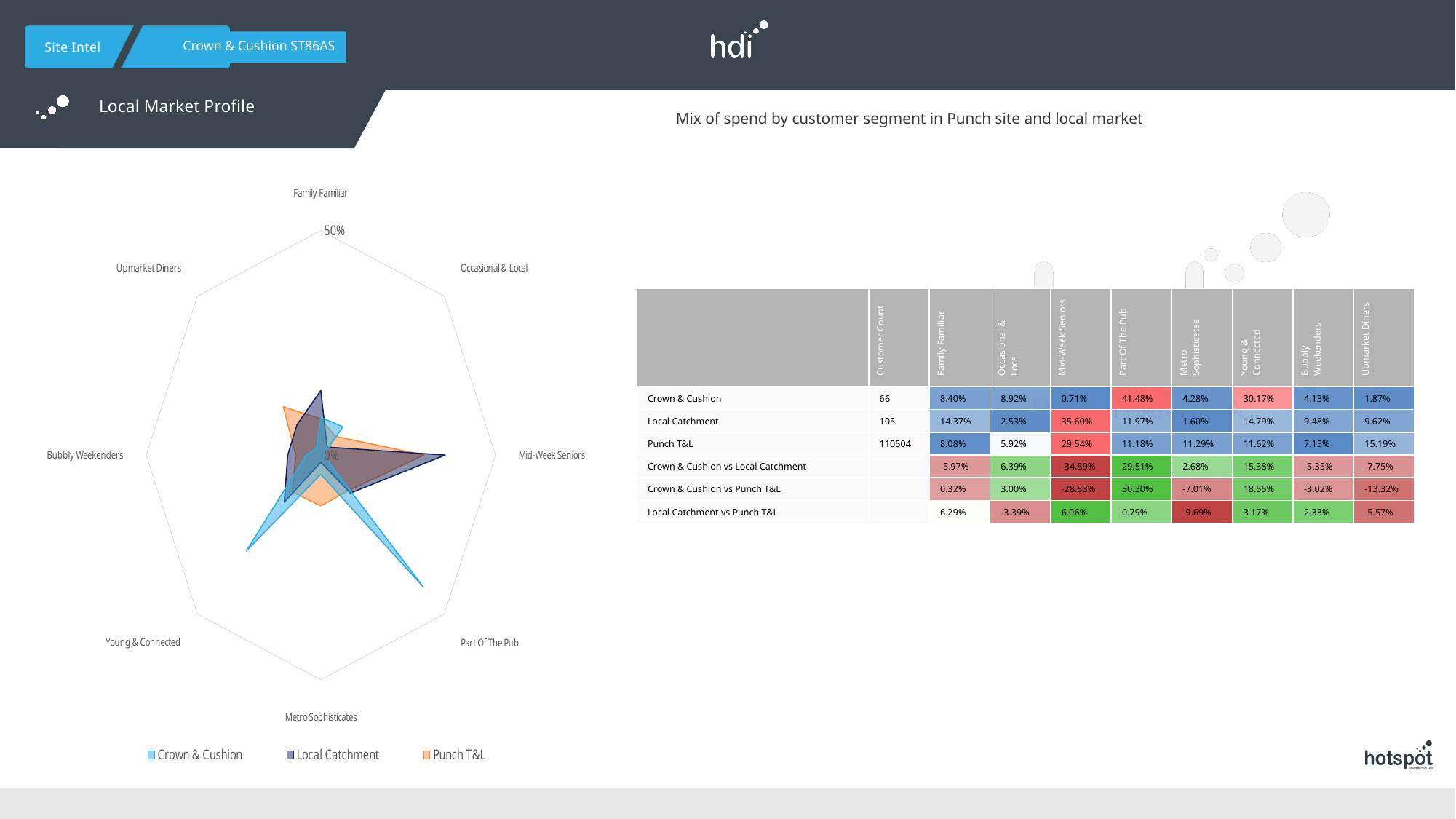
Which customer segment has the highest value for Crown & Cushion? Part Of The Pub What is the outer axis tick value shown on the radar chart? 50% Which customer segment has the highest value for Local Catchment? Mid-Week Seniors How many series does the legend of the radar chart list? 3 For Part Of The Pub, which is larger: Crown & Cushion or Local Catchment? Crown & Cushion What is the Crown & Cushion value for Part Of The Pub? 41.48% How many customer segment axes does the radar chart have? 8 What kind of chart is shown on the left of the slide? Radar chart Is the Crown & Cushion value for Part Of The Pub greater or less than 50%? less Which customer segment has the lowest value for Crown & Cushion? Mid-Week Seniors Which series in the radar chart is shown in orange? Punch T&L What is the Local Catchment value for Mid-Week Seniors? 35.60%